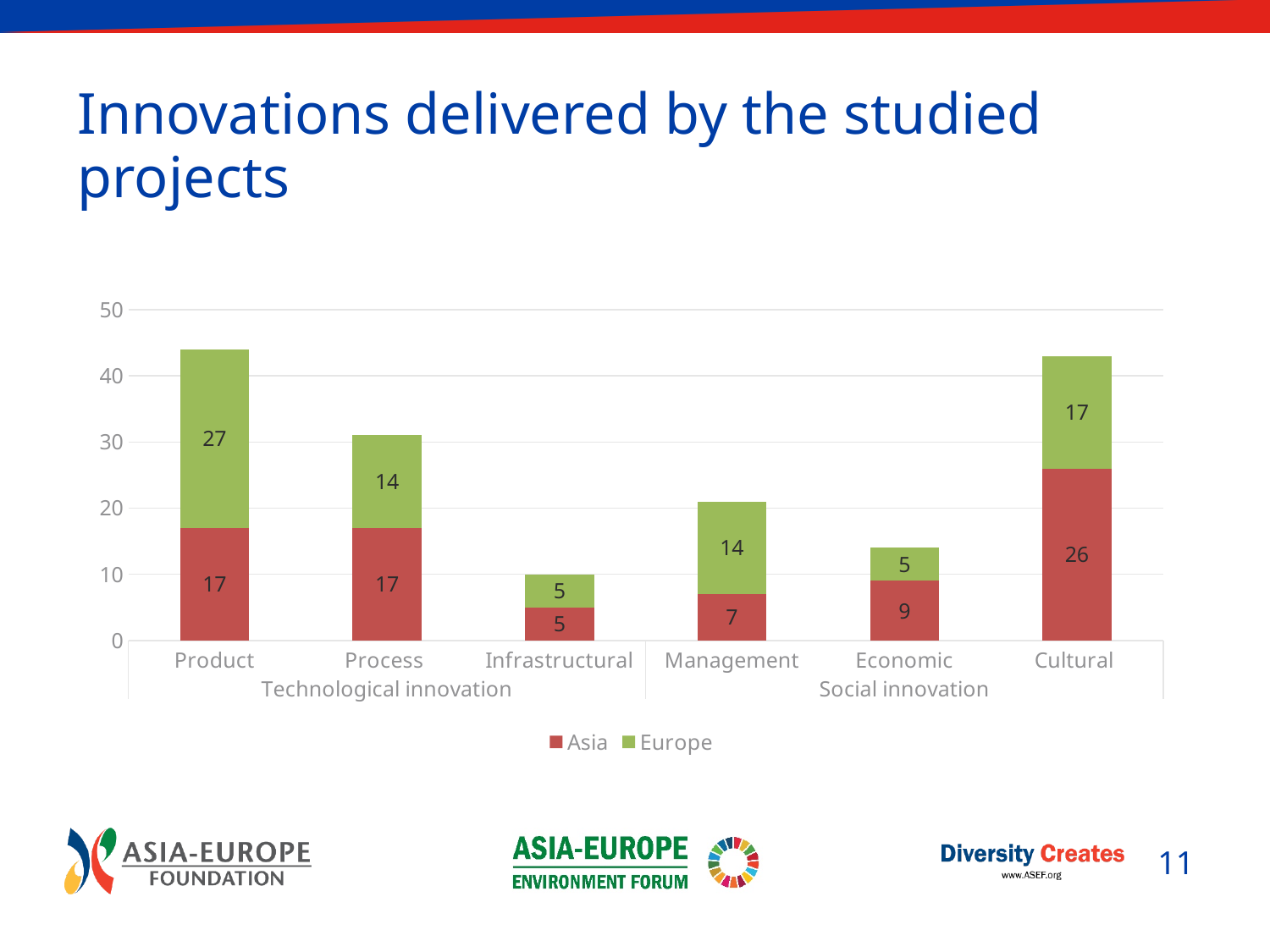
Which category has the highest Europe value? Product What kind of chart is shown on the slide? Stacked bar chart What is the Asia value for Product? 17 What is the Asia value for Economic? 9 What is the total of the stacked bar for Cultural? 43 How many series does the legend list? 2 Which is larger, the Asia value for Cultural or the Asia value for Management? Cultural What is the Europe value for Cultural? 17 What is the total of the stacked bar for Management? 21 Which category has the lowest Asia value? Infrastructural What is the difference between the Europe values for Product and Process? 13 How many categories are shown on the x axis? 6